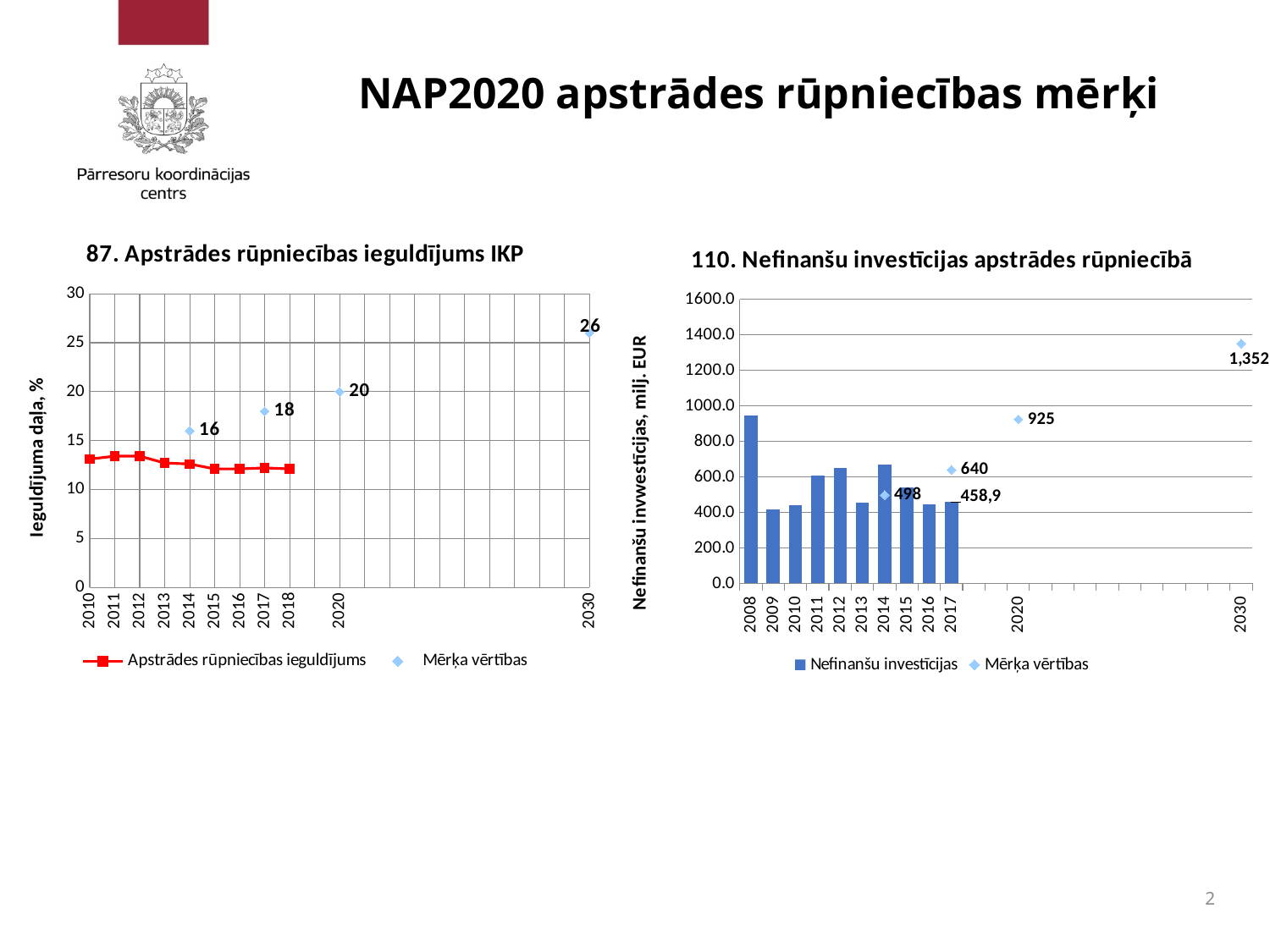
In the chart '87. Apstrādes rūpniecības ieguldījums IKP', what is the target value (Mērķa vērtības) shown for 2020? 20 In the chart '110. Nefinanšu investīcijas apstrādes rūpniecībā', what value is labelled on the Nefinanšu investīcijas bar for 2017? 458,9 In the chart '110. Nefinanšu investīcijas apstrādes rūpniecībā', what is the target value shown for 2030? 1,352 How many series does the legend of the chart '87. Apstrādes rūpniecības ieguldījums IKP' list? 2 In the chart '110. Nefinanšu investīcijas apstrādes rūpniecībā', what is the target value shown for 2020? 925 In the chart '87. Apstrādes rūpniecības ieguldījums IKP', what is the target value shown for 2030? 26 In the chart '87. Apstrādes rūpniecības ieguldījums IKP', is the 2010 value of Apstrādes rūpniecības ieguldījums greater or less than 15? less In the chart '87. Apstrādes rūpniecības ieguldījums IKP', what is the difference between the 2030 target and the 2020 target? 6 How many Nefinanšu investīcijas bars are plotted in the chart '110. Nefinanšu investīcijas apstrādes rūpniecībā'? 10 In the chart '110. Nefinanšu investīcijas apstrādes rūpniecībā', which year has the highest Nefinanšu investīcijas bar? 2008 In the chart '87. Apstrādes rūpniecības ieguldījums IKP', does the red line for Apstrādes rūpniecības ieguldījums rise or fall from 2010 to 2018? fall In the chart '110. Nefinanšu investīcijas apstrādes rūpniecībā', is the Nefinanšu investīcijas bar for 2008 greater or less than 800.0? greater